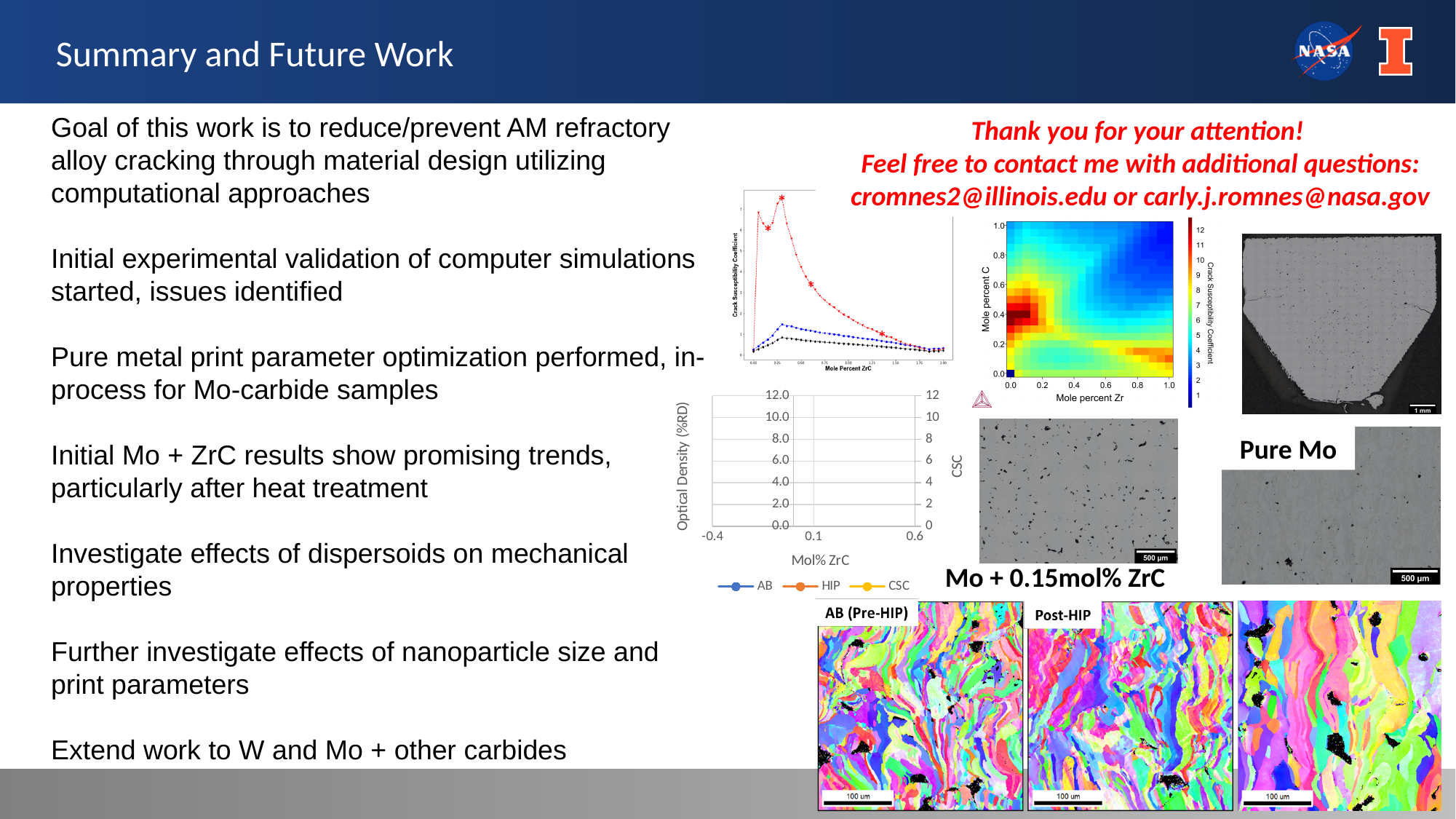
On the chart with the Optical Density (%RD) axis, what is the label of the right-hand y axis? CSC On the heatmap, what is the maximum value shown on the colour scale? 12 On the chart with the Optical Density (%RD) axis, how many series does the legend list? 3 On the heatmap, what is the label of the x axis? Mole percent Zr On the chart with the Optical Density (%RD) axis, what are the series named in the legend? AB, HIP, CSC On the small line chart at the top of the right side, what is the label of the x axis? Mole Percent ZrC On the small line chart at the top of the right side, how many series are plotted? 3 On the heatmap, is the Crack Susceptibility Coefficient at Mole percent Zr 0.8 and Mole percent C 0.8 greater or less than 6? less On the chart with the Optical Density (%RD) axis, what is the label of the x axis? Mol% ZrC On the small line chart at the top of the right side, which series reaches the highest Crack Susceptibility Coefficient: the red, blue or black one? red On the chart with the Optical Density (%RD) axis, what is the highest value shown on the left y axis? 12.0 On the heatmap, what quantity does the colour scale represent? Crack Susceptibility Coefficient